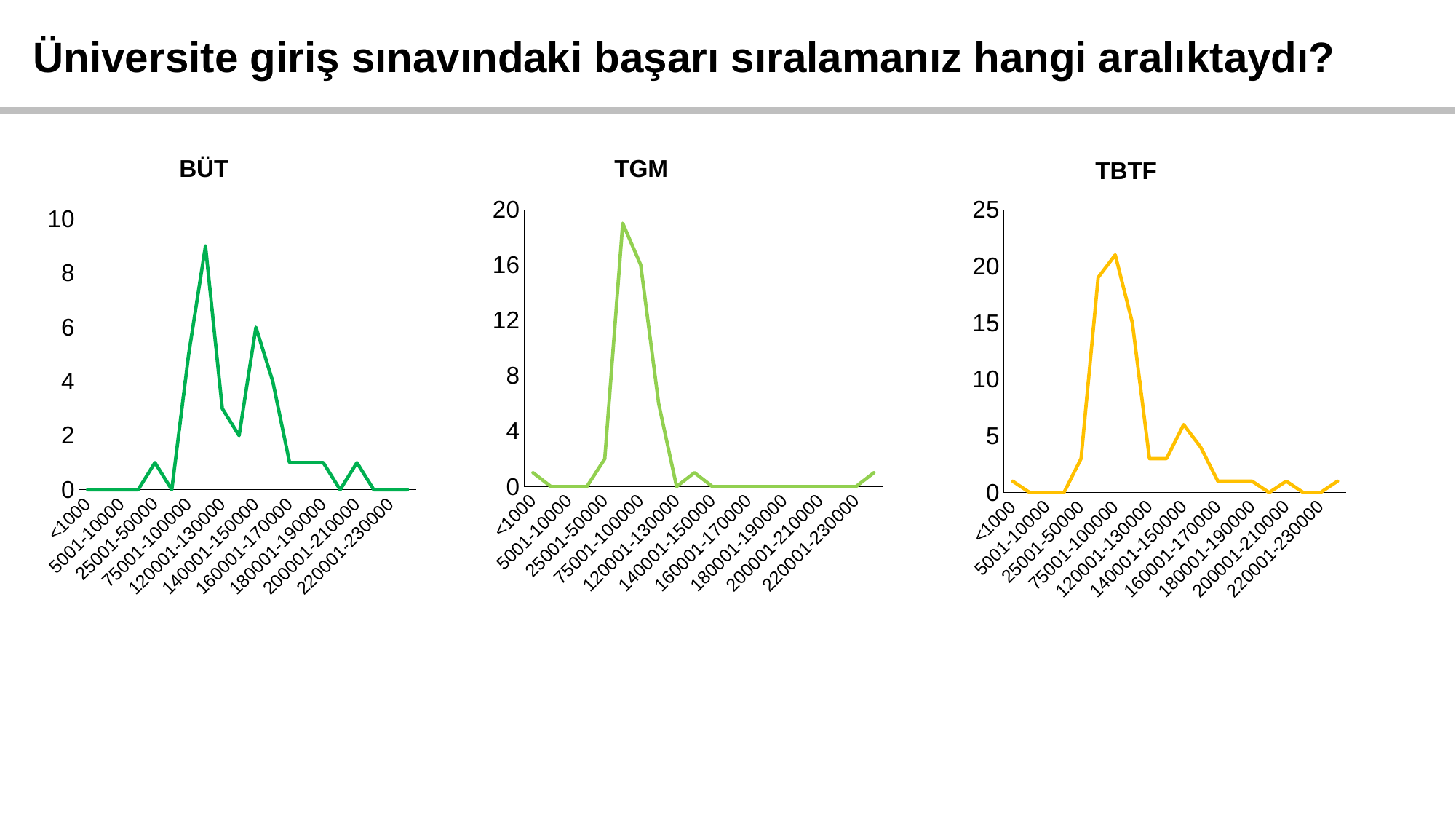
In the TBTF chart, which category has the highest value? 75001-100000 In the TBTF chart, is the value for 75001-100000 greater or less than 15? greater In the TBTF chart, is the value for 5001-10000 greater or less than 5? less Which chart has the higher peak value, BÜT or TGM? TGM In the BÜT chart, is the value for 75001-100000 greater or less than 8? less What are the titles of the three charts, from left to right? BÜT, TGM, TBTF How many charts are shown on the slide? 3 In the TGM chart, do the values rise or fall from 75001-100000 to 120001-130000? fall What kind of chart is the BÜT chart? line chart